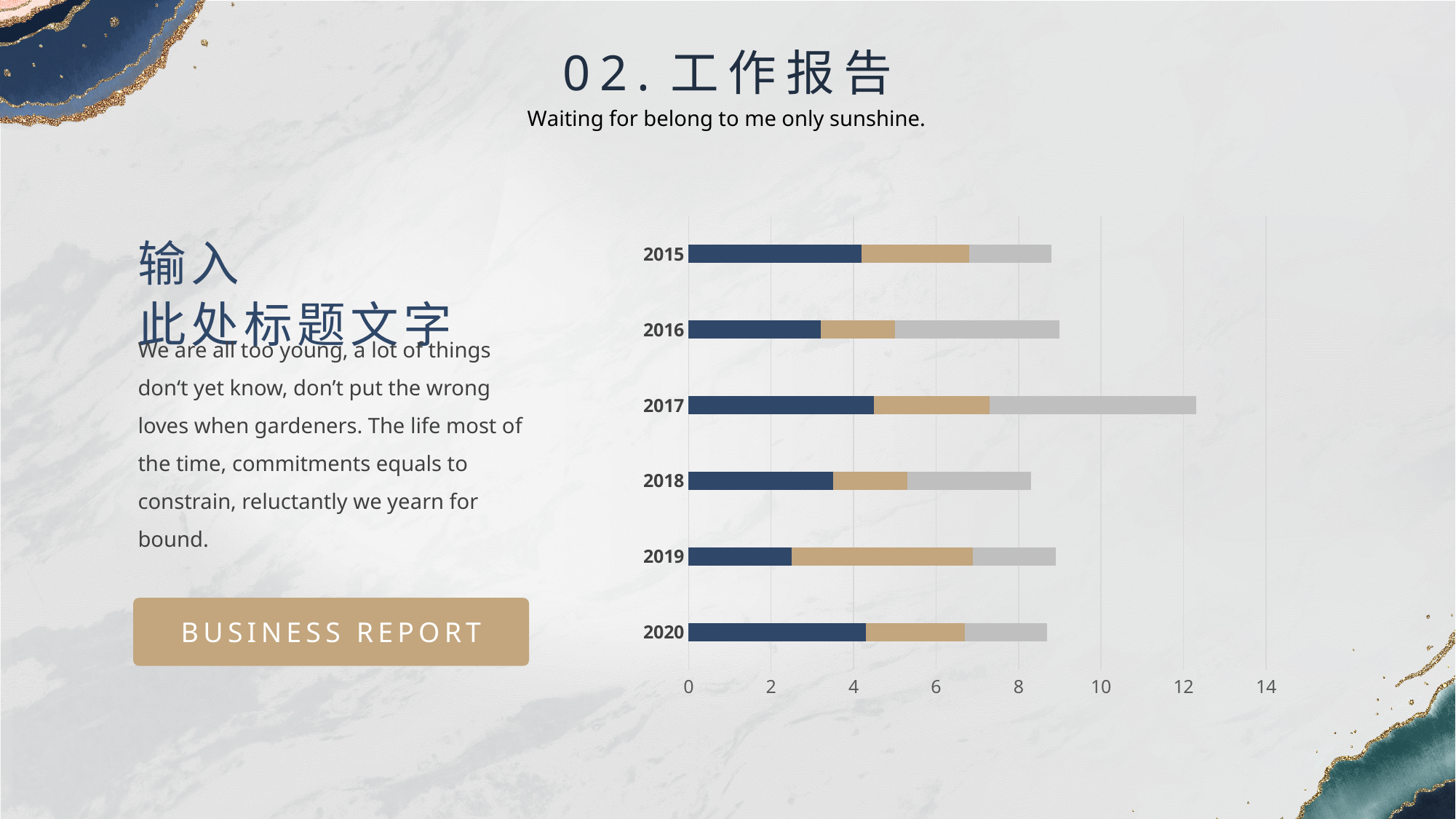
Is the total bar length for 2018 greater or less than 10? less What kind of chart is shown on the slide? bar chart Which year has the longer dark blue segment, 2017 or 2019? 2017 Is the total bar length for 2017 greater or less than 10? greater Which year has the shortest dark blue (first) segment? 2019 How many coloured segments make up each stacked bar? 3 How many years (categories) are plotted on the chart? 6 Which year has the longest total bar? 2017 What is the highest value shown on the horizontal axis? 14 Which total bar is longer, 2017 or 2018? 2017 Is the total bar length for 2015 greater or less than 8? greater